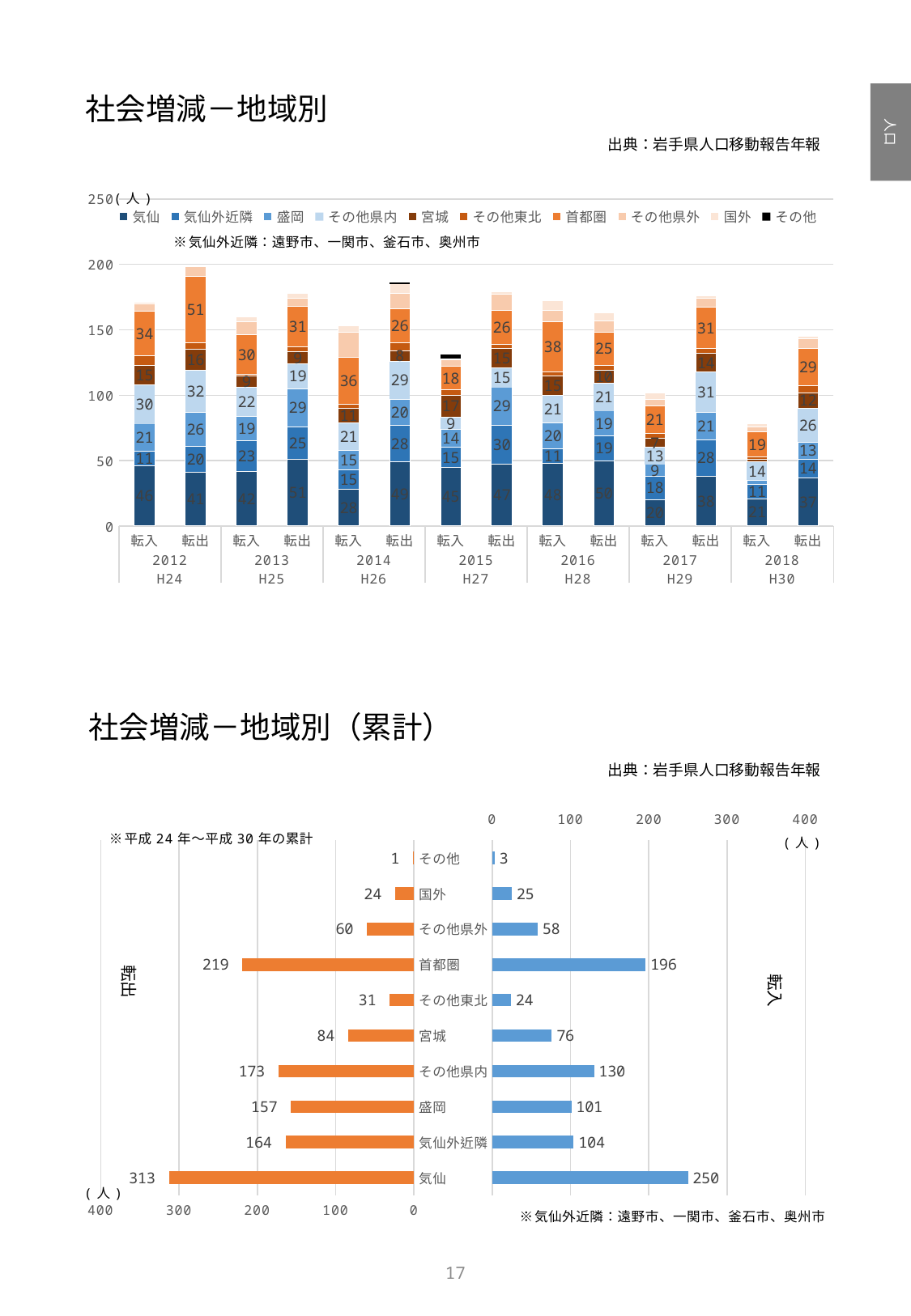
In the bottom chart (社会増減－地域別（累計）), what is the 転入 value for 首都圏? 196 In the bottom chart (社会増減－地域別（累計）), which category has the lowest 転出 value? その他 In the bottom chart (社会増減－地域別（累計）), what is the difference between the 転出 and 転入 values for 盛岡? 56 In the top chart (社会増減－地域別), how many series does the legend list? 10 What kind of chart is the top chart (社会増減－地域別)? Stacked bar chart In the bottom chart (社会増減－地域別（累計）), how many categories are shown? 10 In the bottom chart (社会増減－地域別（累計）), what is the 転出 value for 気仙? 313 In the bottom chart (社会増減－地域別（累計）), which is larger for 国外: the 転出 value or the 転入 value? 転入 In the top chart (社会増減－地域別), what is the 首都圏 value for 転入 in 2014 (H26)? 36 In the top chart (社会増減－地域別), is the total of the 転入 bar for 2018 (H30) greater or less than 100? less In the bottom chart (社会増減－地域別（累計）), which category has the highest 転入 value? 気仙 In the top chart (社会増減－地域別), what is the 首都圏 value for 転出 in 2012 (H24)? 51